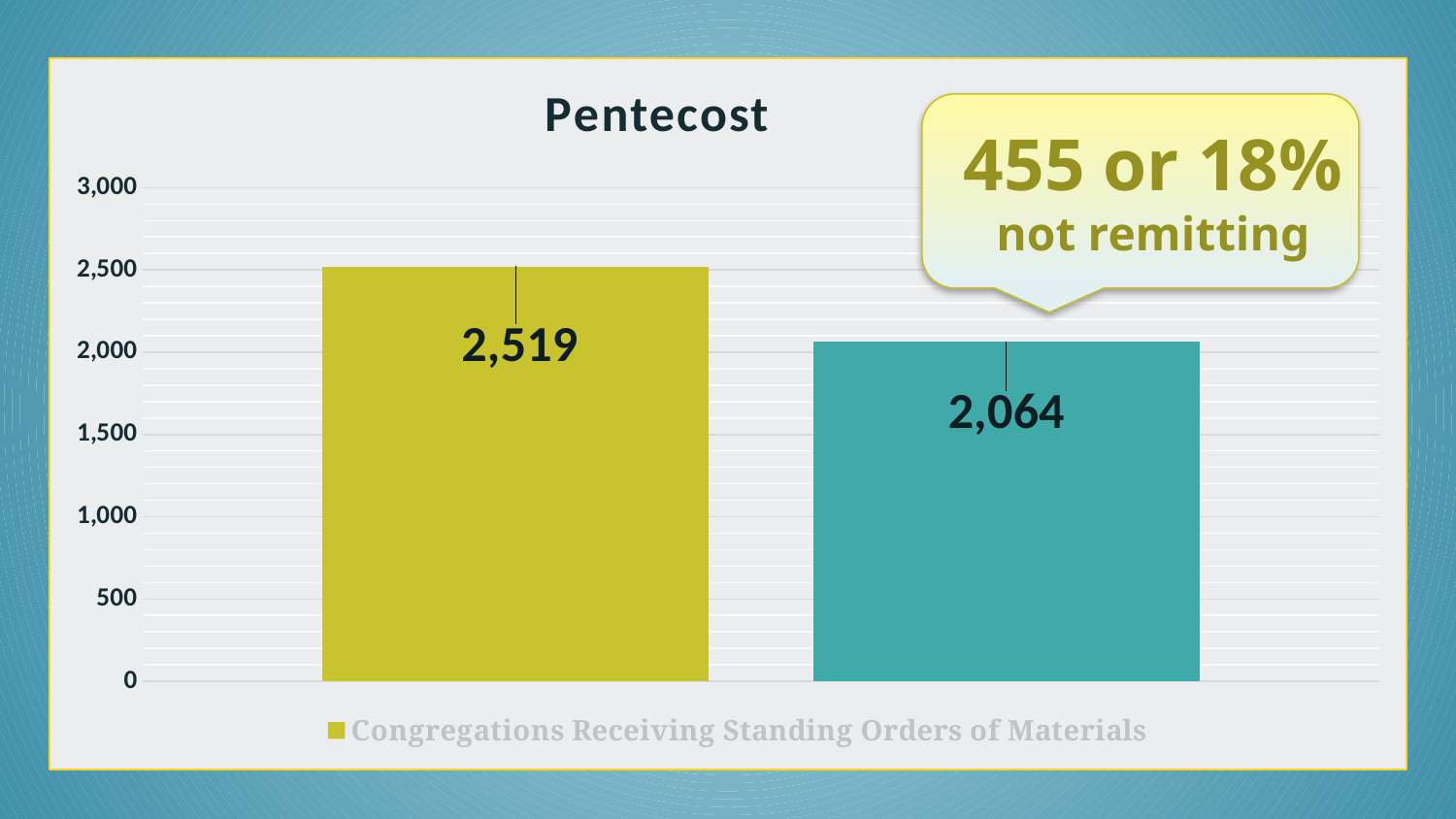
What is the difference between the yellow bar's value and the teal bar's value? 455 What is the title of the chart? Pentecost What is the highest value plotted on the chart? 2,519 What is the value shown on the yellow bar? 2,519 What is the lowest value plotted on the chart? 2,064 How many bars are plotted on the chart? 2 Which bar is taller, the yellow bar on the left or the teal bar on the right? the yellow bar on the left What is the value shown on the teal bar? 2,064 What kind of chart is shown on the slide? bar chart Is the value of the yellow bar greater or less than 2,000? greater Is the value of the teal bar greater or less than 2,500? less How many entries does the legend list? 1